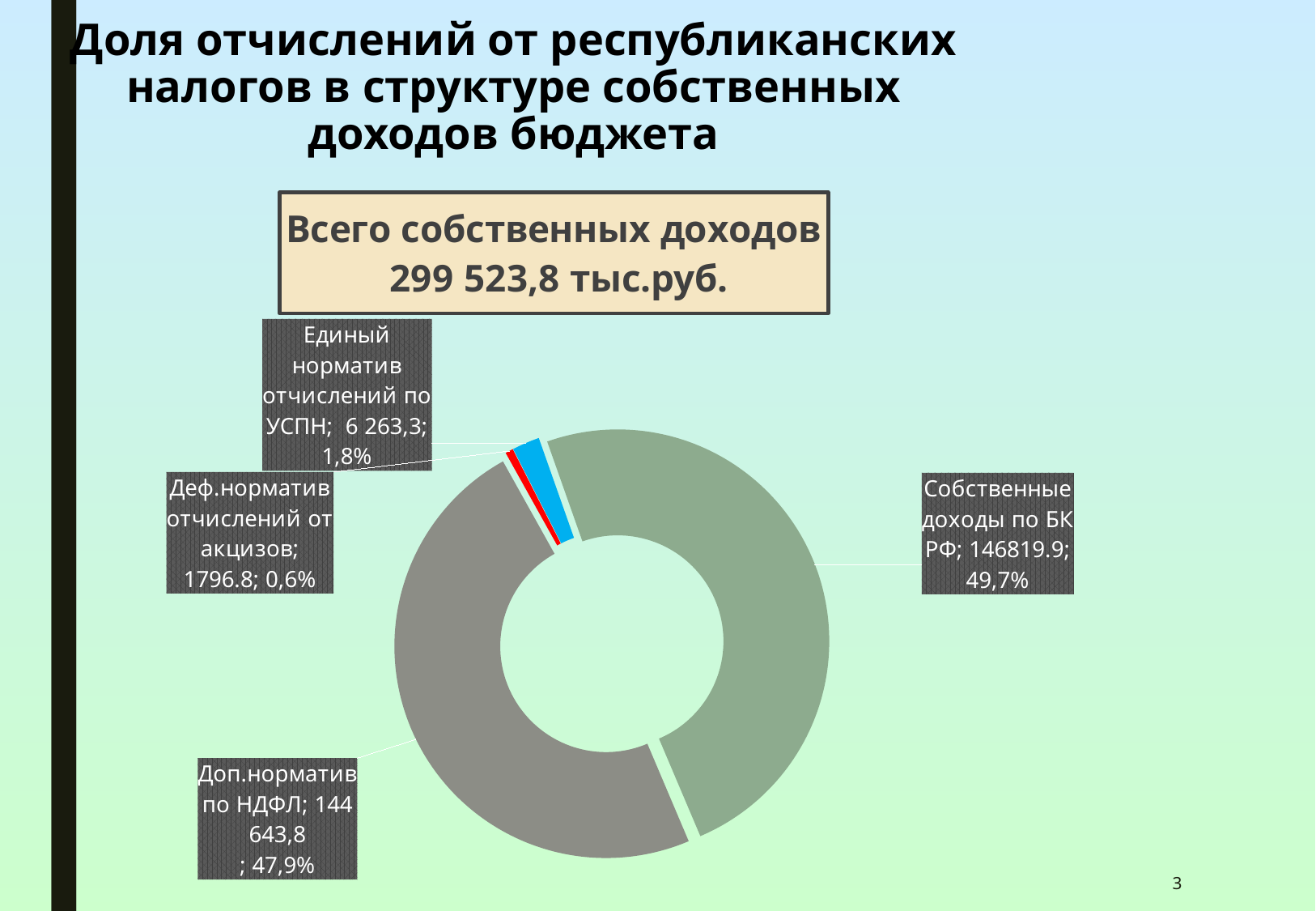
What is the value for Деф.норматив отчислений от акцизов? 1796.8 What share of the doughnut does Доп.норматив по НДФЛ take? 47,9% What is the value for Собственные доходы по БК РФ? 146819.9 Which category has the smallest slice? Деф.норматив отчислений от акцизов What share of the doughnut does Собственные доходы по БК РФ take? 49,7% What total of own revenues is stated in the box above the chart? 299 523,8 тыс.руб. How many slices does the doughnut chart have? 4 What is the difference in percentage share between Единый норматив отчислений по УСПН and Деф.норматив отчислений от акцизов? 1,2% What is the value for Единый норматив отчислений по УСПН? 6 263,3 What is the value for Доп.норматив по НДФЛ? 144 643,8 Which category has the largest slice? Собственные доходы по БК РФ What kind of chart is shown on the slide? doughnut chart